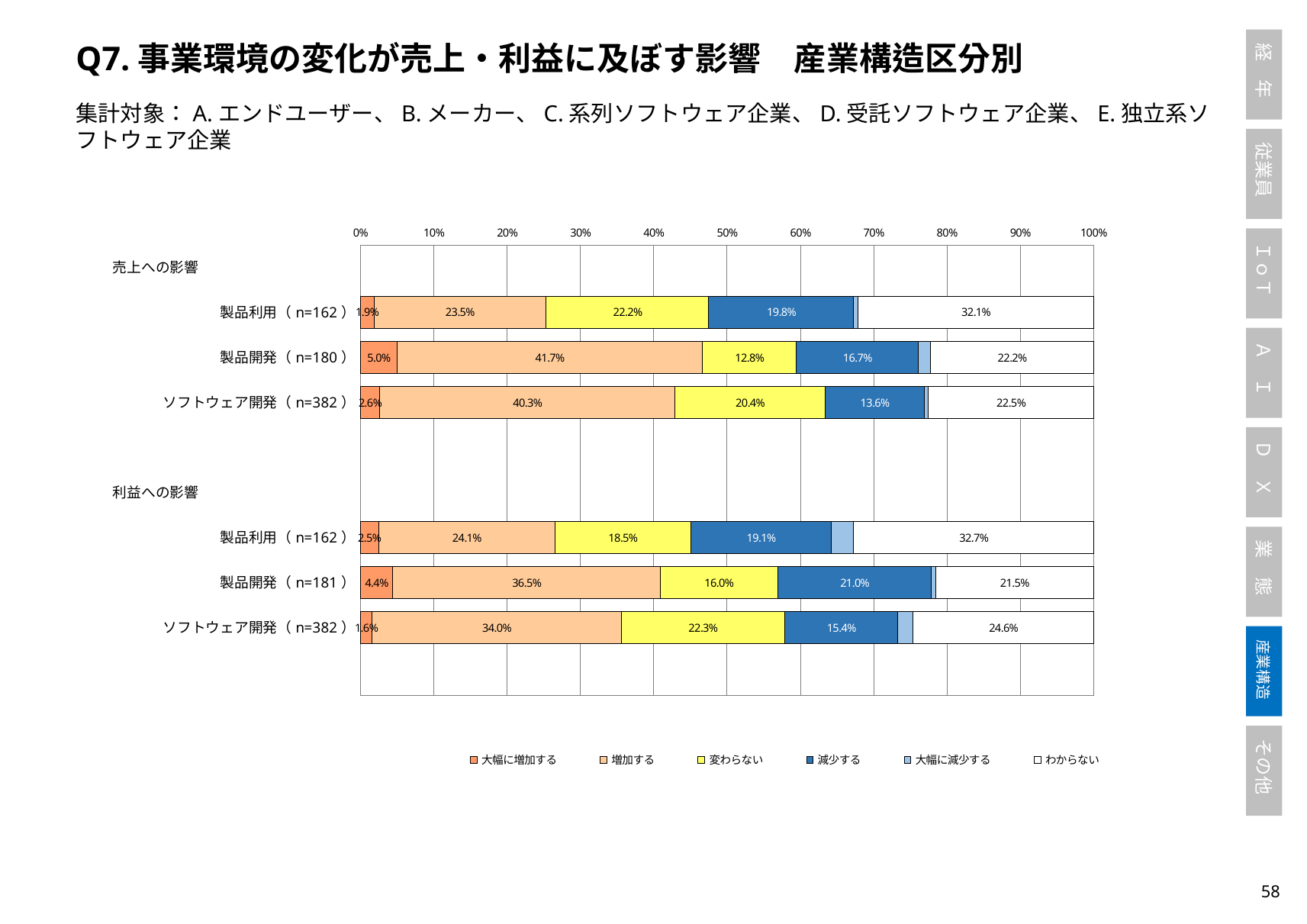
What is the sample size (n) shown for 製品開発 in the 利益への影響 group? 181 In the 売上への影響 group, what is the value of 変わらない for ソフトウェア開発 (n=382)? 20.4% In the 利益への影響 group, what is the value of わからない for ソフトウェア開発 (n=382)? 24.6% What kind of chart is shown on the slide? Stacked bar chart How many category bars are plotted in the chart in total? 6 In the 利益への影響 group, which category has the lowest value for 大幅に増加する? ソフトウェア開発 What is the first entry in the chart's legend? 大幅に増加する What is the difference between the わからない value for 製品利用 in the 利益への影響 group (32.7%) and in the 売上への影響 group (32.1%)? 0.6 percentage points How many series does the legend list? 6 For 製品開発, is the 減少する value larger in the 売上への影響 group or the 利益への影響 group? 利益への影響 In the 売上への影響 group, what is the value of 増加する for 製品開発 (n=180)? 41.7% In the 売上への影響 group, which category has the highest value for 増加する? 製品開発